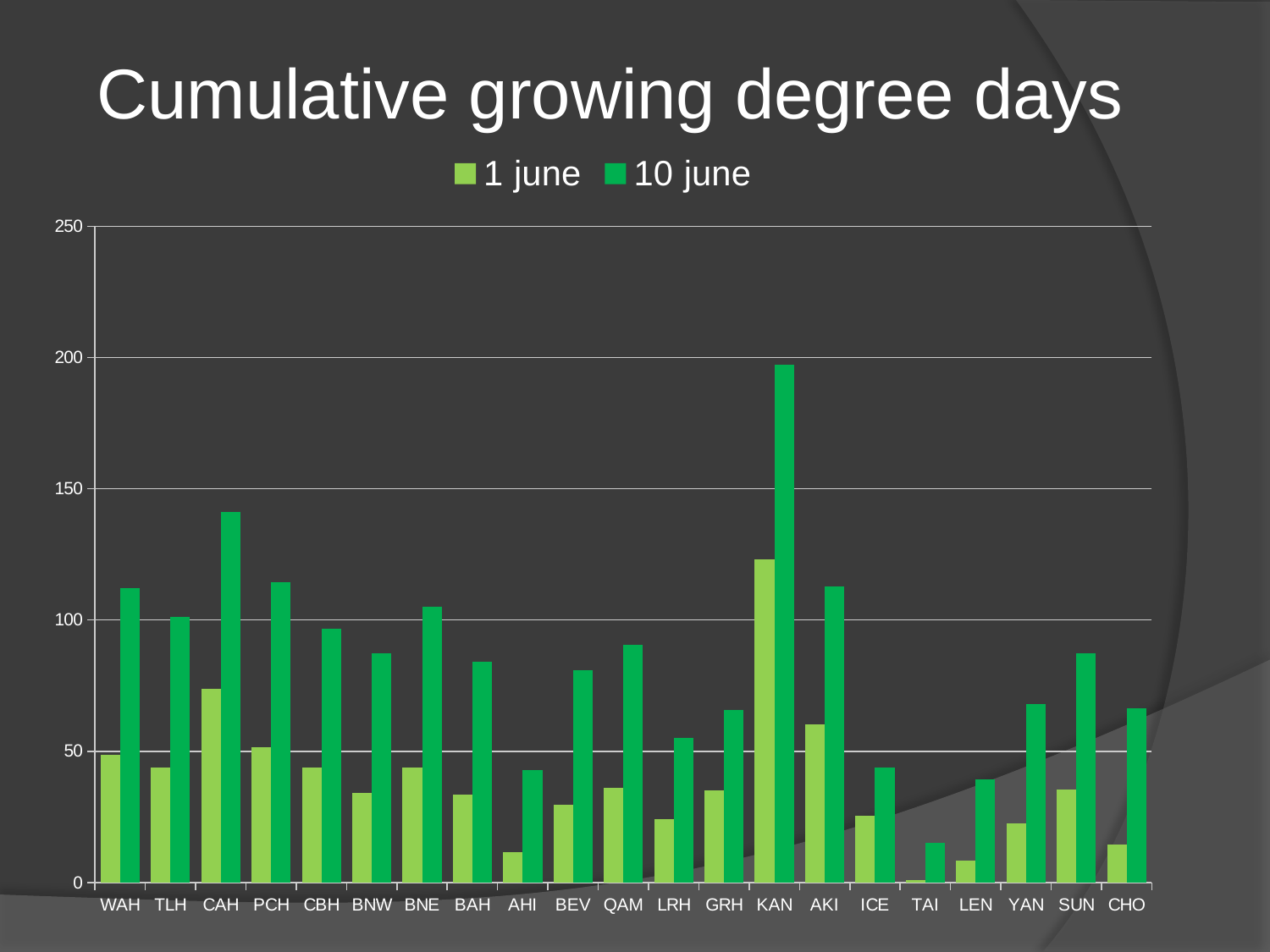
What kind of chart is shown on the slide? bar chart Is the 10 june value for CAH greater or less than 150? less Which station has the lowest 1 june value? TAI What is the title of the chart? Cumulative growing degree days Which station has the lowest 10 june value? TAI Which station has the highest 1 june value? KAN How many stations (categories) are shown on the x axis? 21 Which is larger, the 10 june value for CAH or the 10 june value for PCH? CAH How many series does the legend list? 2 Is the 1 june value for AHI greater or less than 50? less Is the 10 june value for KAN greater or less than 150? greater Which station has the highest 10 june value? KAN